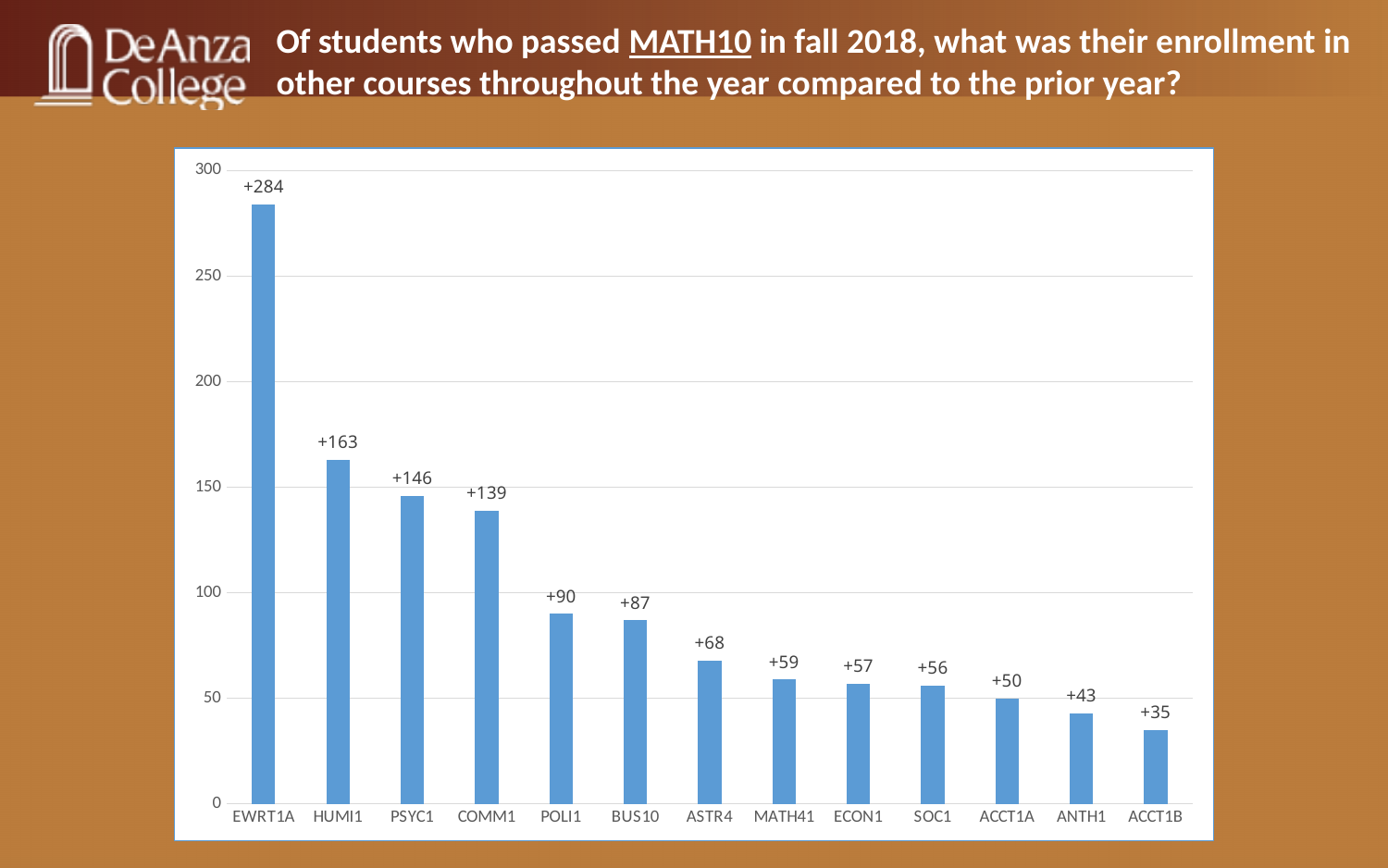
Do the values rise or fall from left to right along the x axis? fall What is the value shown for EWRT1A? +284 Which course has the lowest value? ACCT1B What is the value shown for POLI1? +90 What is the difference between the values for HUMI1 and PSYC1? 17 How many courses are shown on the x axis? 13 Which course has the highest value? EWRT1A What is the difference between the values for EWRT1A and ACCT1B? 249 What is the value shown for ACCT1A? +50 Is the value for COMM1 greater or less than 150? less What kind of chart is shown on the slide? bar chart Which has a larger value, BUS10 or ASTR4? BUS10